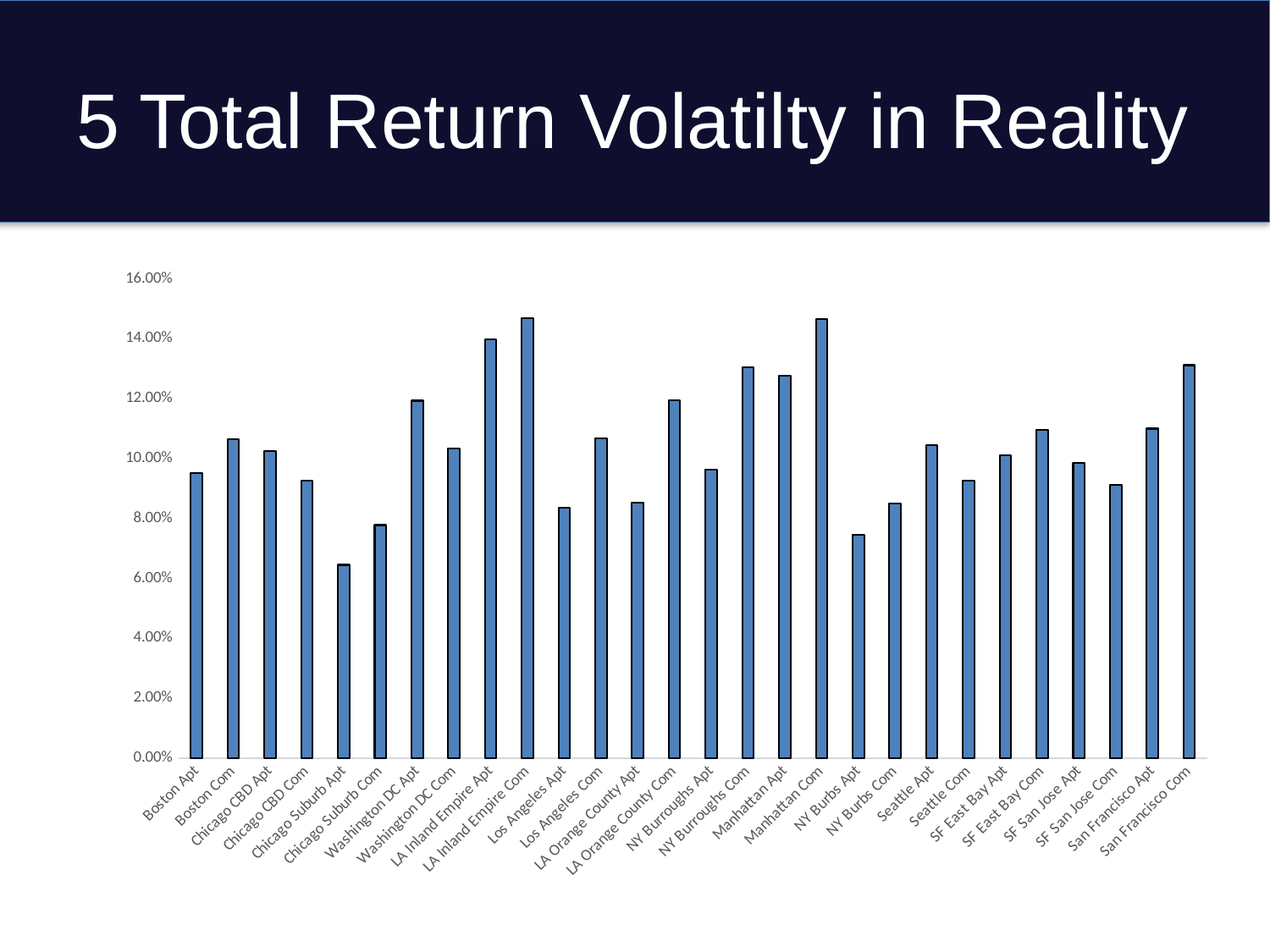
Which is larger, the value for Manhattan Com or the value for Manhattan Apt? Manhattan Com Is the value for NY Burbs Apt greater or less than 8.00%? less Which category has the lowest value in the chart? Chicago Suburb Apt Is the value for Manhattan Com greater or less than 14.00%? greater Is the value for Chicago Suburb Apt greater or less than 6.00%? greater Which is larger, the value for Seattle Apt or the value for Seattle Com? Seattle Apt Which is larger, the value for Boston Com or the value for Boston Apt? Boston Com How many categories (bars) are plotted in the chart? 28 What is the title of the slide containing the chart? 5 Total Return Volatilty in Reality What kind of chart is shown on the slide? bar chart